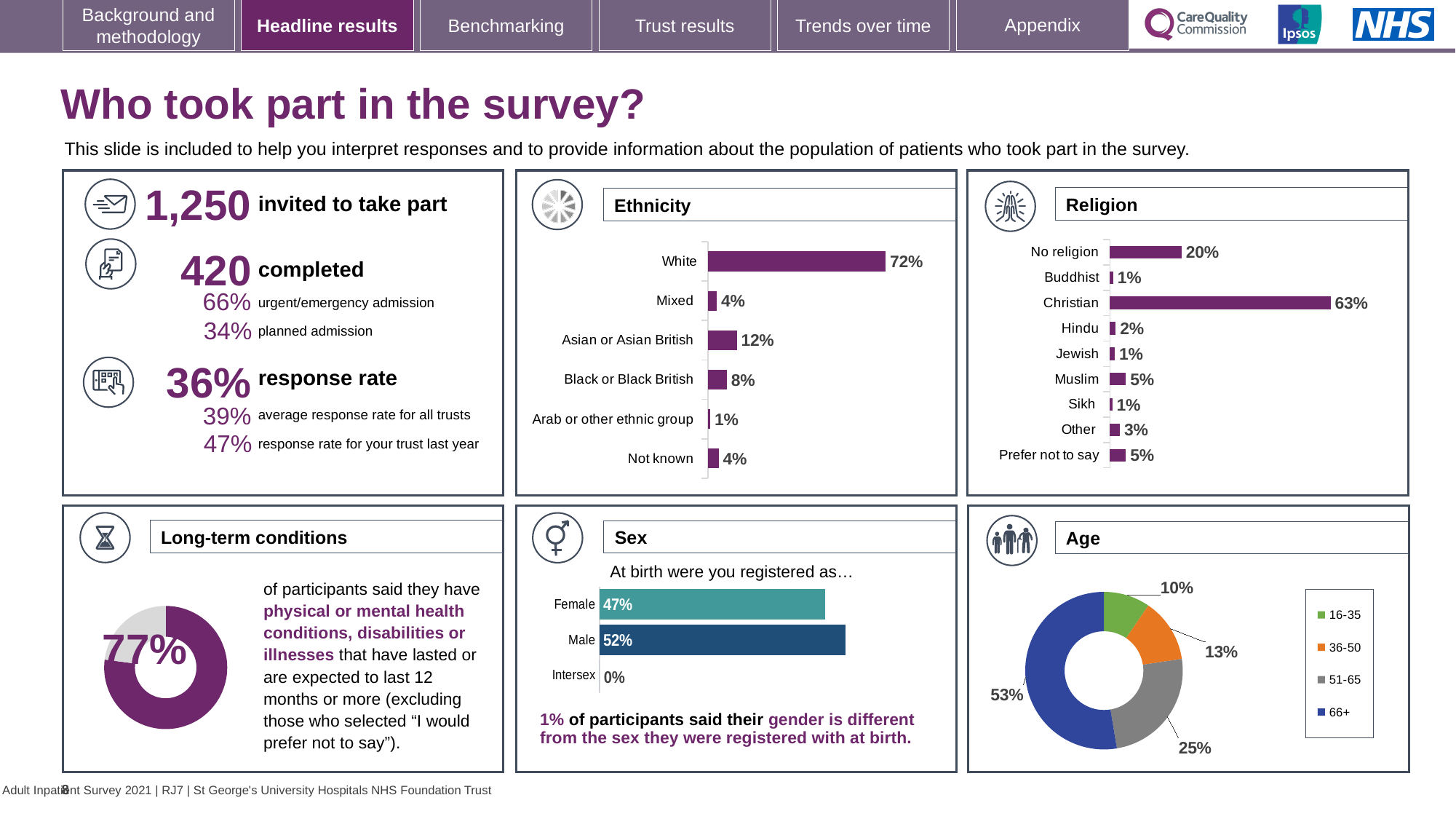
In the Religion chart, which religion category has the highest percentage? Christian In the Age chart, how many age groups does the legend list? 4 In the Sex chart, what is the difference between the Male and Female percentages? 5% In the Ethnicity chart, which ethnic group has the lowest percentage? Arab or other ethnic group In the Ethnicity chart, what is the difference between the Asian or Asian British and Black or Black British percentages? 4% In the Ethnicity chart, what percentage of participants were White? 72% In the Religion chart, what percentage of participants were Christian? 63% In the Religion chart, how many religion categories are shown? 9 In the Religion chart, which is larger: No religion or Muslim? No religion What kind of chart is the Age chart? Doughnut chart In the Age chart, what share of participants were aged 66+? 53% In the Sex chart, what percentage of participants were registered as Male at birth? 52%